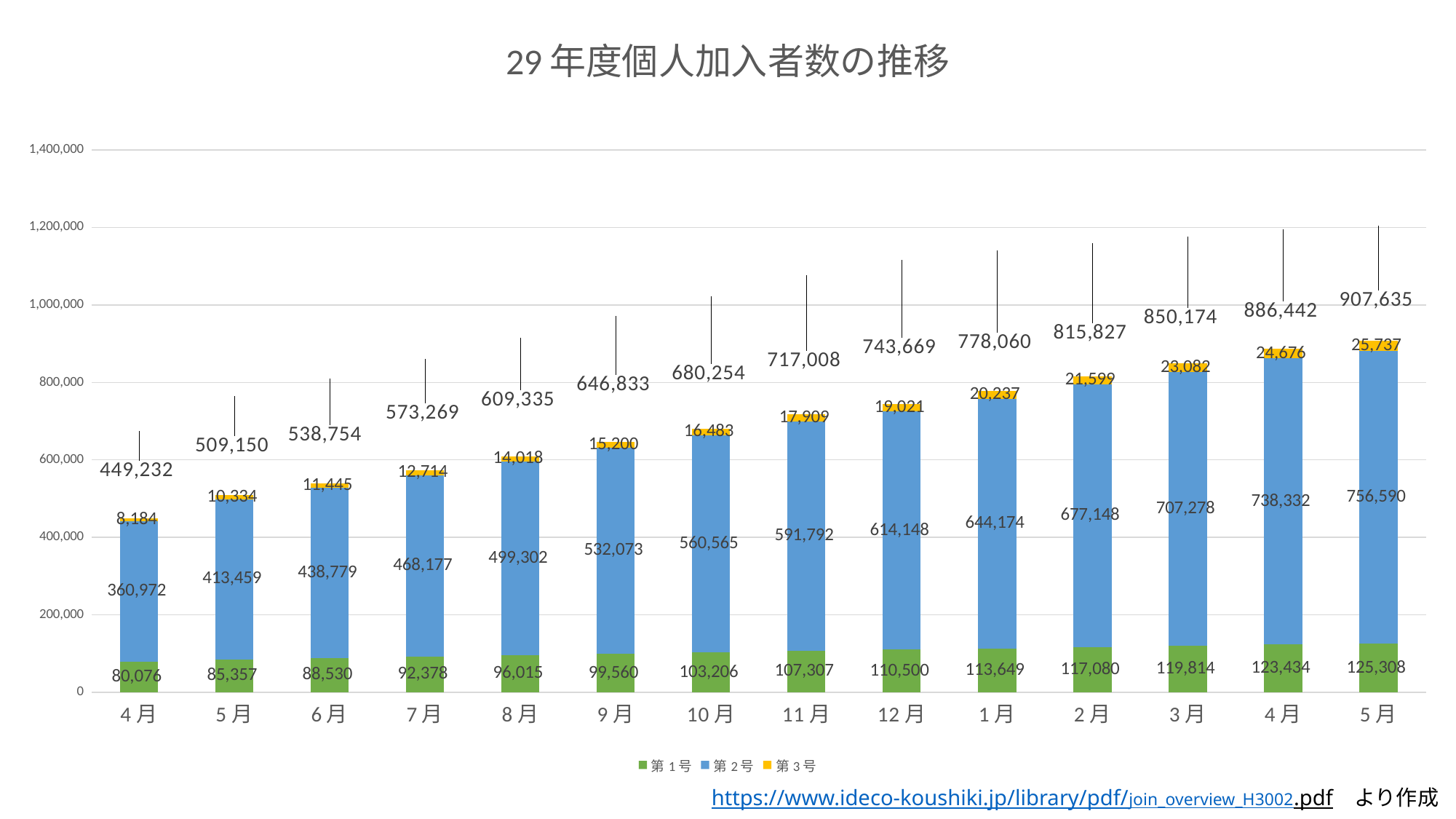
What is the total shown above the bar for 1月? 778,060 What is the 第1号 value for 12月? 110,500 What is the 第2号 value for 10月? 560,565 Which month has the highest total number of subscribers? 5月 (the last bar) How many series does the legend list? 3 Is the 第1号 value larger for 2月 or for 11月? 2月 What type of chart is shown on the slide? stacked bar chart What is the difference between the 第2号 values for 9月 and 8月? 32,771 What is the 第3号 value for 3月? 23,082 Which month has the lowest total number of subscribers? 4月 (the first bar) Do the total values rise or fall from left to right along the x axis? rise How many months (bars) are plotted on the chart? 14